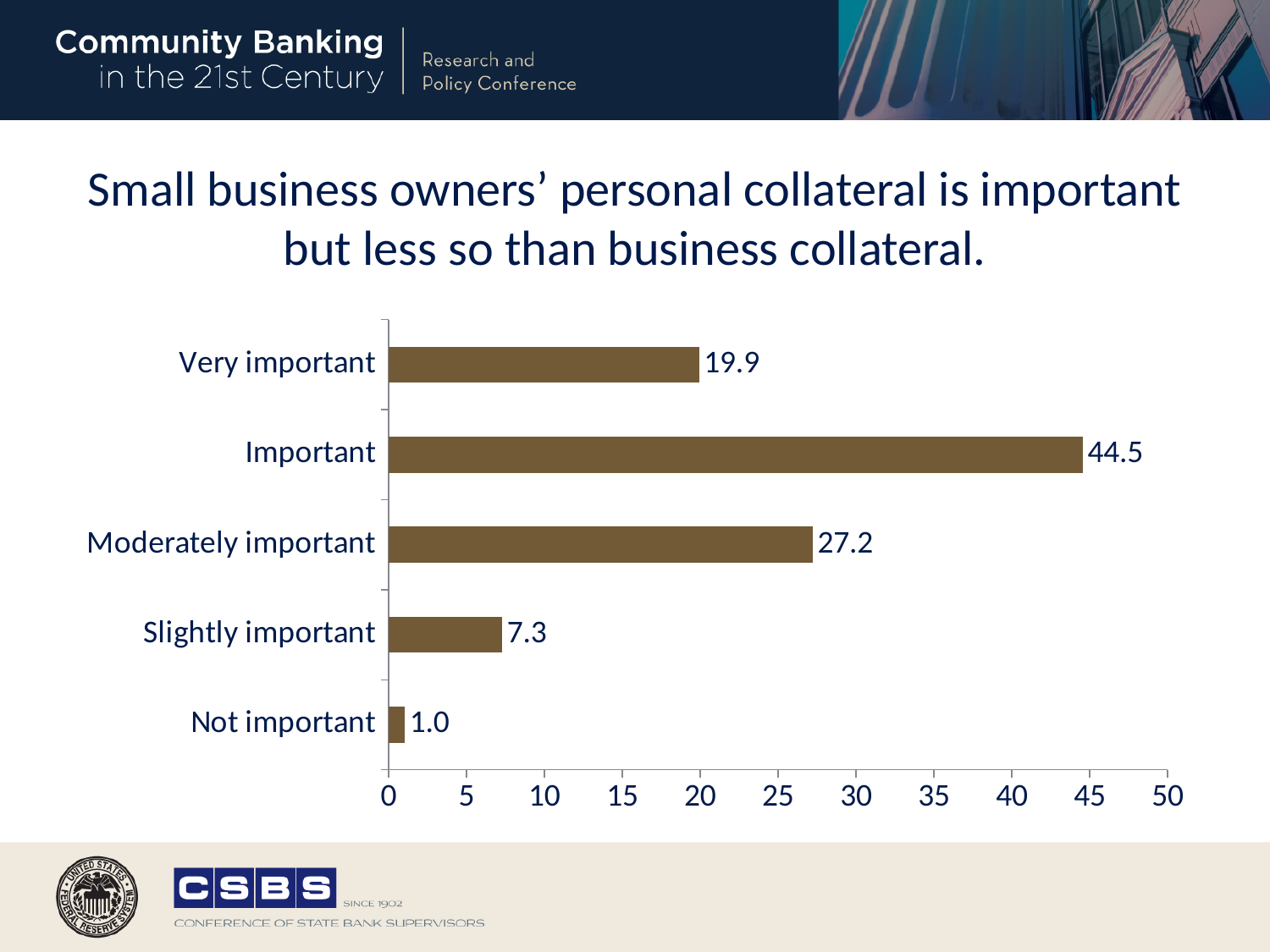
How many categories are shown in the chart? 5 What is the value for Moderately important? 27.2 What is the maximum value shown on the horizontal axis? 50 Which category has the lowest value? Not important What is the difference between the values for Important and Moderately important? 17.3 What is the value for Not important? 1.0 What kind of chart is shown on the slide? Bar chart Which is larger, the value for Very important or the value for Moderately important? Moderately important What is the value for Important? 44.5 Which category has the highest value? Important What is the value for Slightly important? 7.3 What is the value for Very important? 19.9